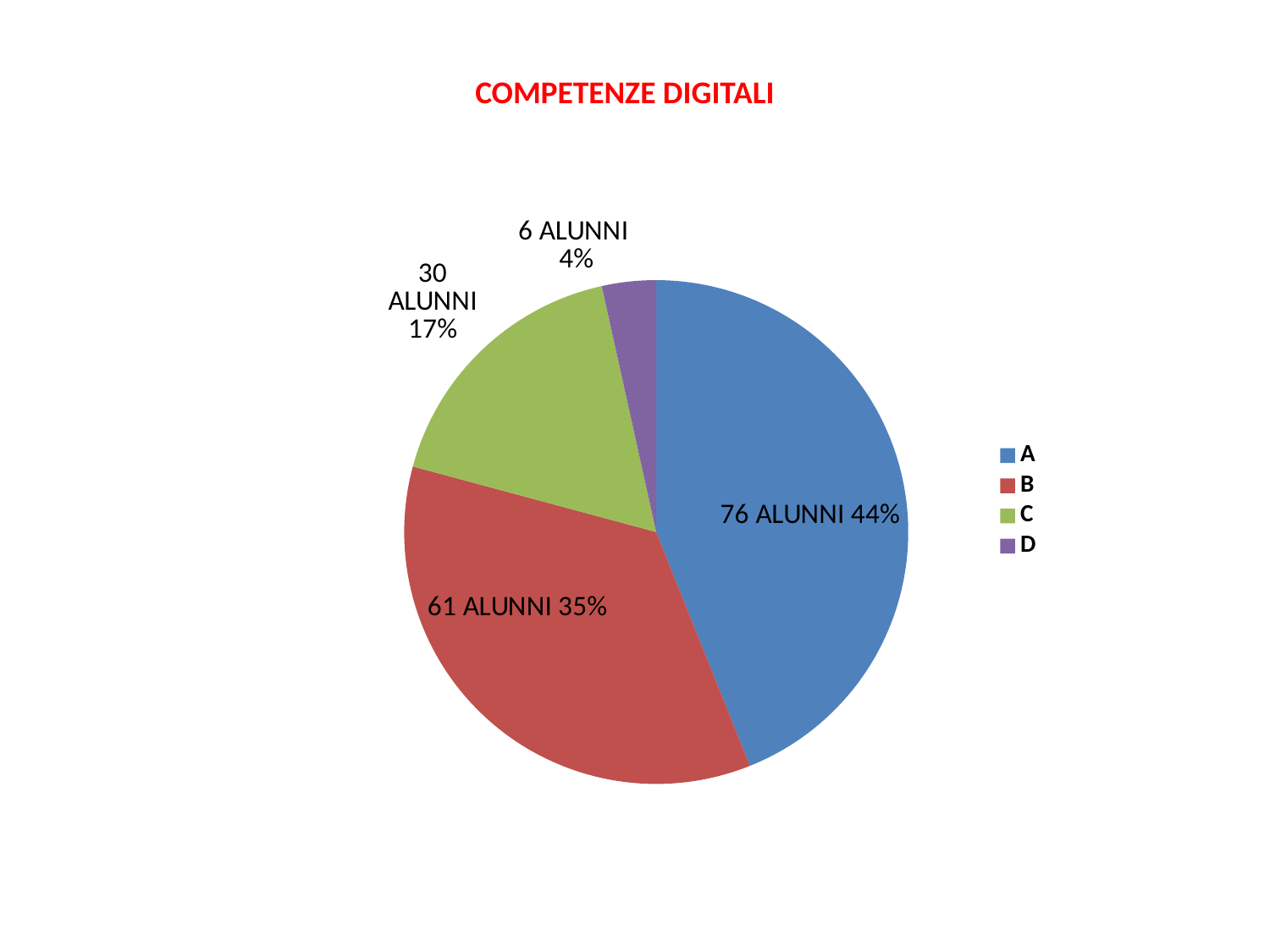
How many alunni are in category C? 30 ALUNNI How many entries does the legend list? 4 Which category has the largest slice? A Which category has the smallest slice? D How many alunni are in category A? 76 ALUNNI What percentage share of the pie does category D have? 4% What is the title of the chart? COMPETENZE DIGITALI What is the difference in number of alunni between category A and category B? 15 What percentage share of the pie does category C have? 17% What kind of chart is shown on the slide? pie chart How many alunni are in category B? 61 ALUNNI How many slices does the pie chart have? 4